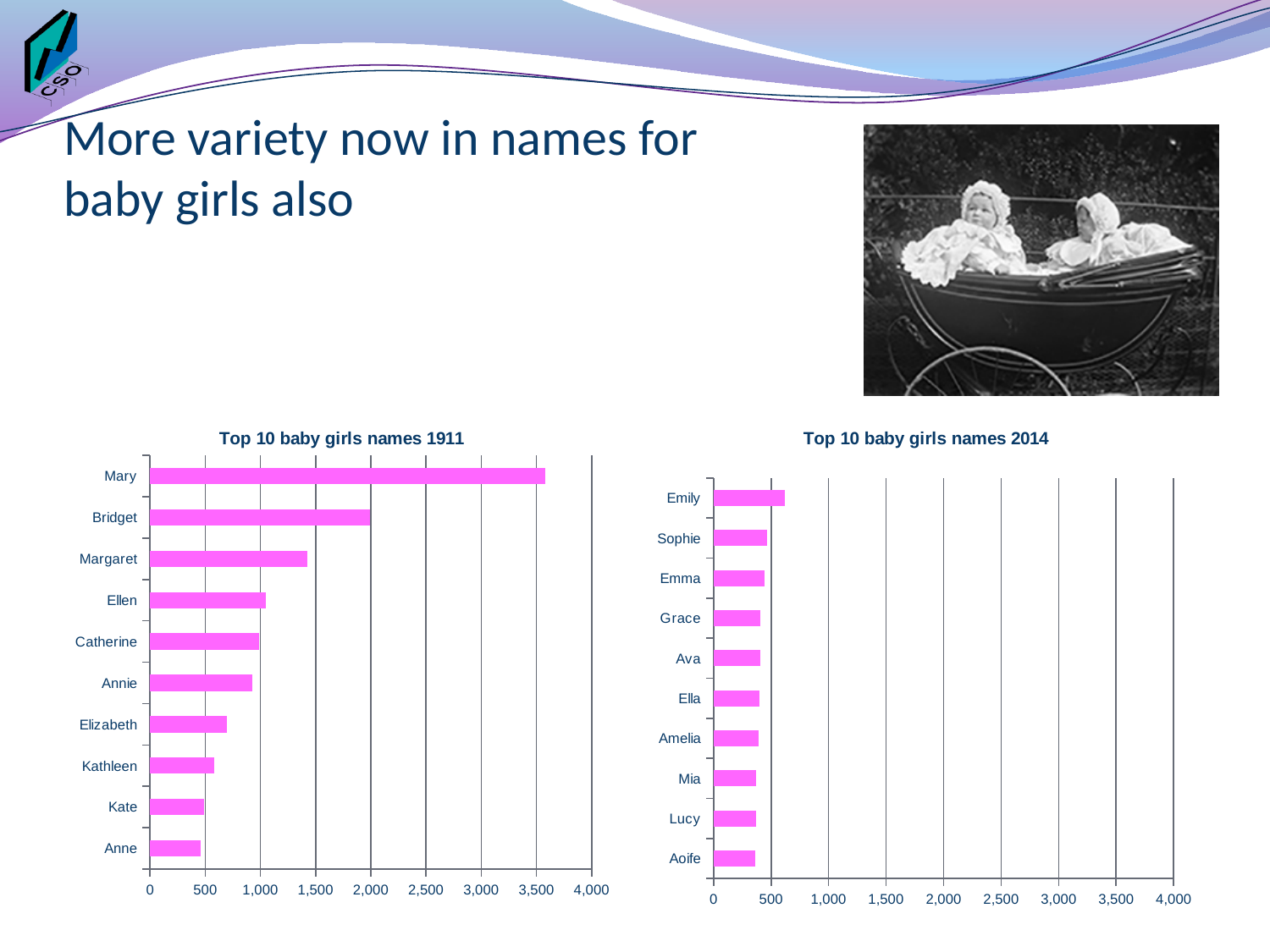
In the 'Top 10 baby girls names 1911' chart, is the value for Elizabeth greater or less than 1,000? less In the 'Top 10 baby girls names 2014' chart, which name has the lowest value? Aoife In the 'Top 10 baby girls names 1911' chart, which name has the lowest value? Anne How many names are shown in the 'Top 10 baby girls names 2014' chart? 10 In the 'Top 10 baby girls names 1911' chart, is the value for Mary greater or less than 3,500? greater In the 'Top 10 baby girls names 1911' chart, which is larger, the value for Mary or the value for Bridget? Mary In the 'Top 10 baby girls names 2014' chart, is the value for Emily greater or less than 500? greater In the 'Top 10 baby girls names 2014' chart, which name has the highest value? Emily What kind of chart is the 'Top 10 baby girls names 1911' chart? Bar chart In the 'Top 10 baby girls names 1911' chart, which name has the highest value? Mary